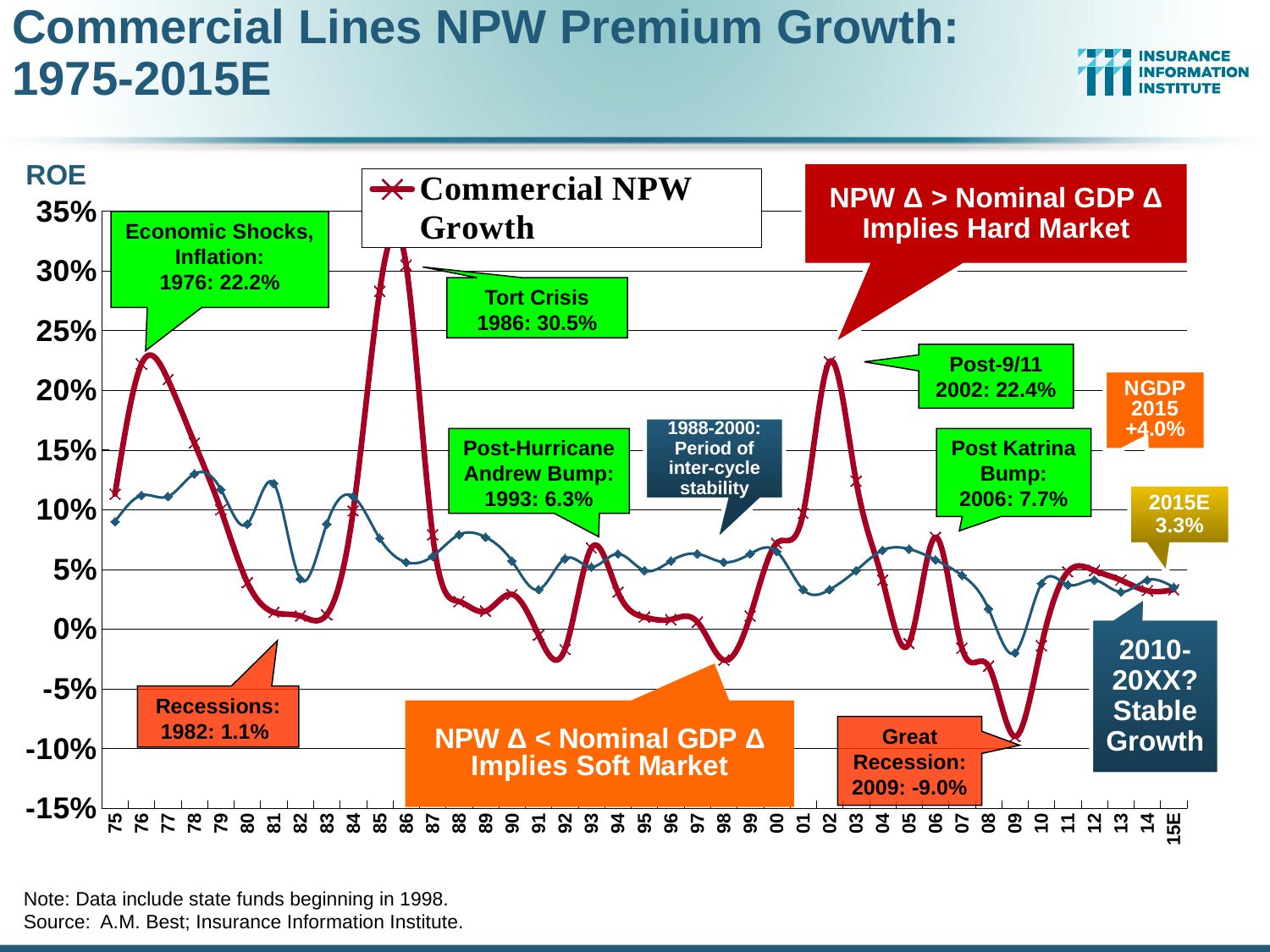
In which year did Commercial NPW growth reach its lowest point on the chart? 2009 Is the Commercial NPW growth value for 1985 greater or less than 25%? greater In which year did Commercial NPW growth reach its highest point on the chart? 1986 What is the title of the slide? Commercial Lines NPW Premium Growth: 1975-2015E What Commercial NPW growth value is given for 1976? 22.2% What kind of chart is shown on the slide? Line chart How many series does the chart legend list? 1 What was Commercial NPW growth in 1986 according to the Tort Crisis callout? 30.5% What was Commercial NPW growth in 2009 according to the Great Recession callout? -9.0% What is the estimated Commercial NPW growth for 2015E? 3.3% Which year had higher Commercial NPW growth, 1976 or 2002? 2002 How much higher was Commercial NPW growth in 1986 (30.5%) than in 2002 (22.4%)? 8.1 percentage points